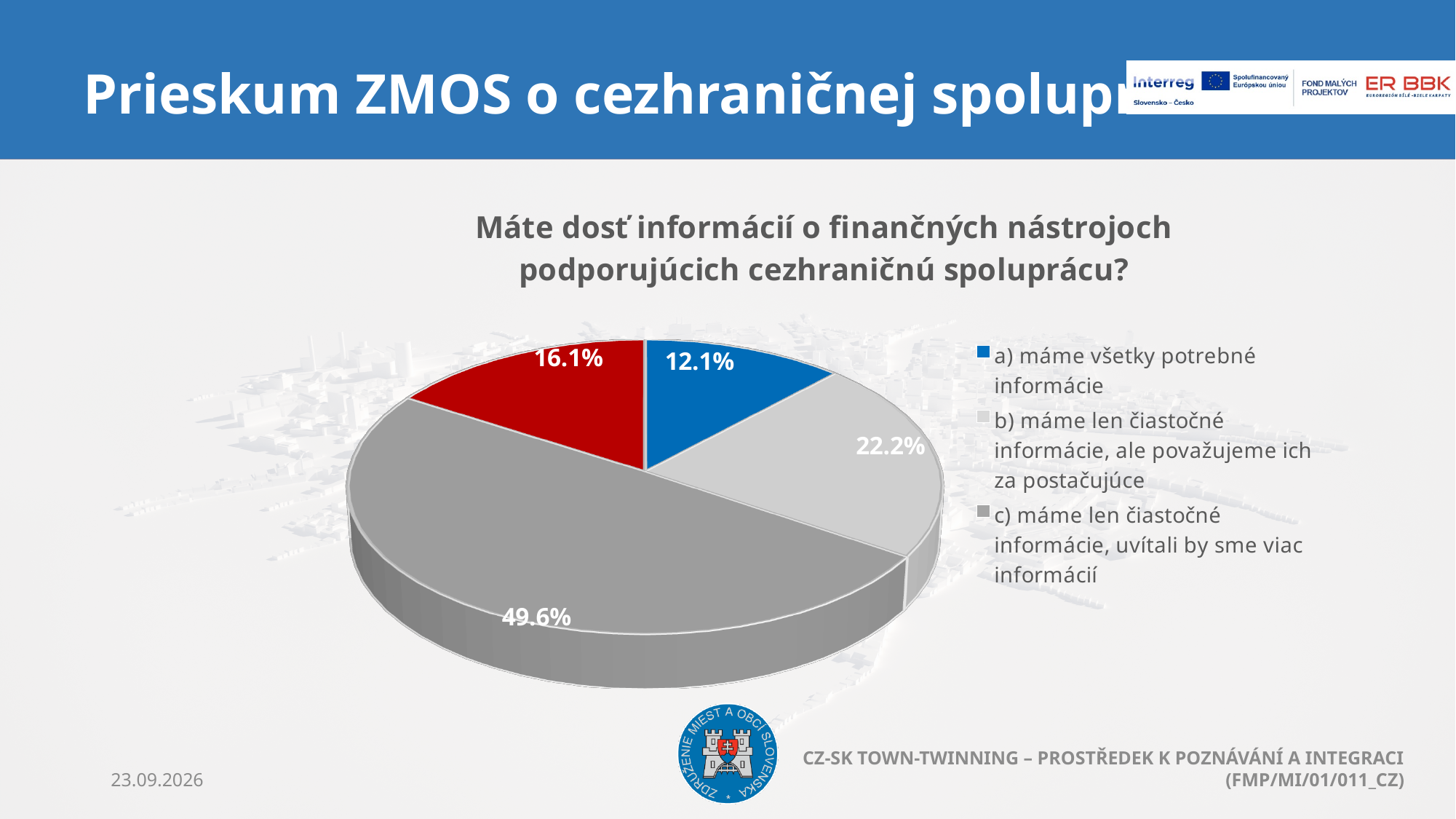
How many percentage points larger is the share for answer c) than for answer b)? 27.4% How many slices does the pie chart have? 4 What share of respondents answered "b) máme len čiastočné informácie, ale považujeme ich za postačujúce"? 22.2% What colour is the slice for answer a) máme všetky potrebné informácie? blue Which legend category has the smallest share of the pie? a) máme všetky potrebné informácie What is the difference between the shares for answer b) and answer a)? 10.1% Which has the larger share: answer a) or answer b)? b) máme len čiastočné informácie, ale považujeme ich za postačujúce Which legend category has the largest share of the pie? c) máme len čiastočné informácie, uvítali by sme viac informácií What is the title of the pie chart? Máte dosť informácií o finančných nástrojoch podporujúcich cezhraničnú spoluprácu? What share of respondents answered "a) máme všetky potrebné informácie"? 12.1% What share of respondents answered "c) máme len čiastočné informácie, uvítali by sme viac informácií"? 49.6% What kind of chart is shown on the slide? pie chart